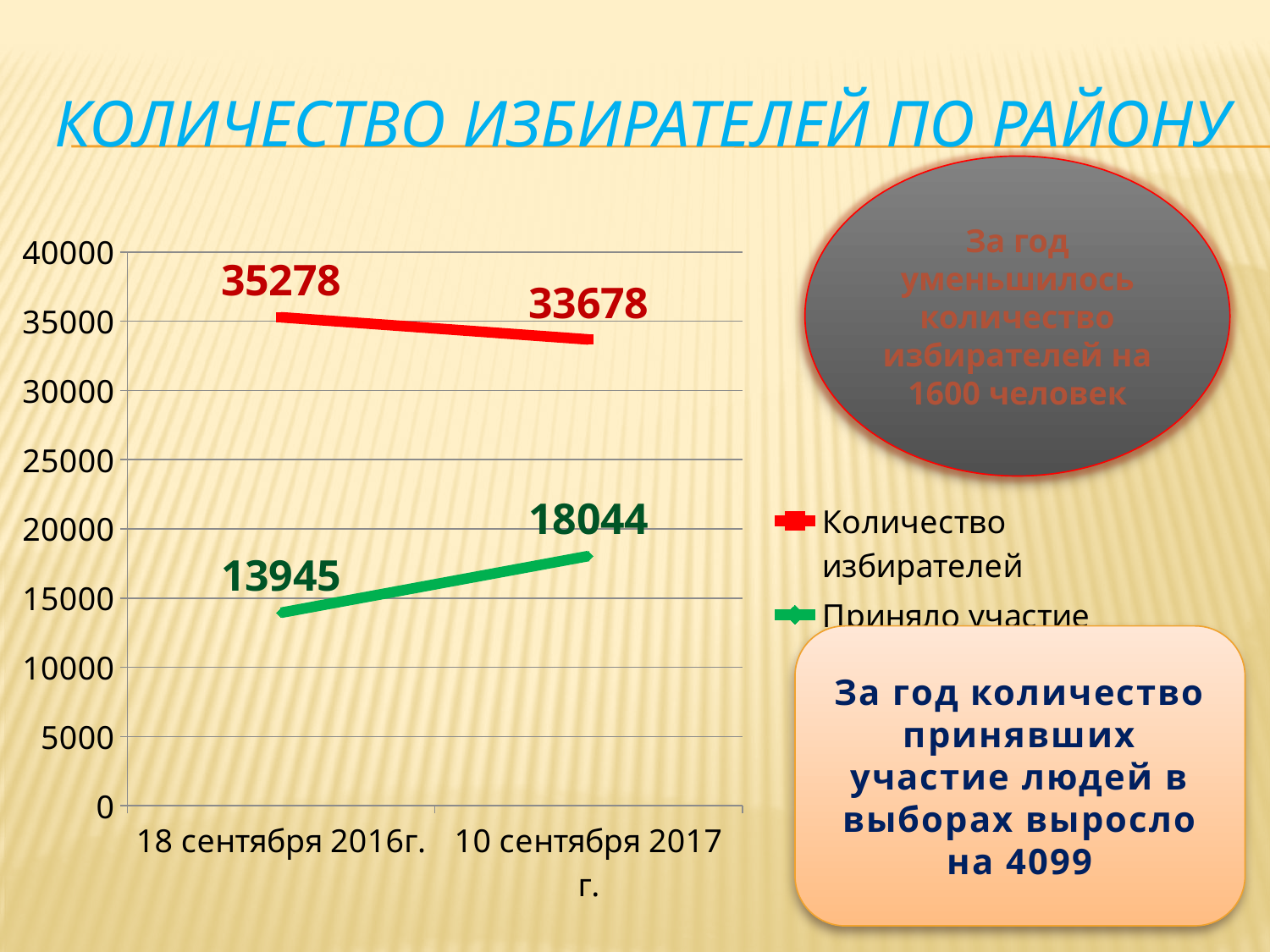
How many series does the legend list? 2 What is the value of "Приняло участие" for 10 сентября 2017 г.? 18044 What is the value of "Количество избирателей" for 10 сентября 2017 г.? 33678 What type of chart is shown on the slide? line chart By how much did "Количество избирателей" change from 18 сентября 2016г. to 10 сентября 2017 г.? 1600 Which is larger: "Количество избирателей" for 18 сентября 2016г. or for 10 сентября 2017 г.? 18 сентября 2016г. Does the "Количество избирателей" series rise or fall from 18 сентября 2016г. to 10 сентября 2017 г.? fall What is the value of "Количество избирателей" for 18 сентября 2016г.? 35278 What is the value of "Приняло участие" for 18 сентября 2016г.? 13945 What colour is the line for "Количество избирателей"? red Does the "Приняло участие" series rise or fall from 18 сентября 2016г. to 10 сентября 2017 г.? rise What is the difference between the "Приняло участие" values for 10 сентября 2017 г. and 18 сентября 2016г.? 4099